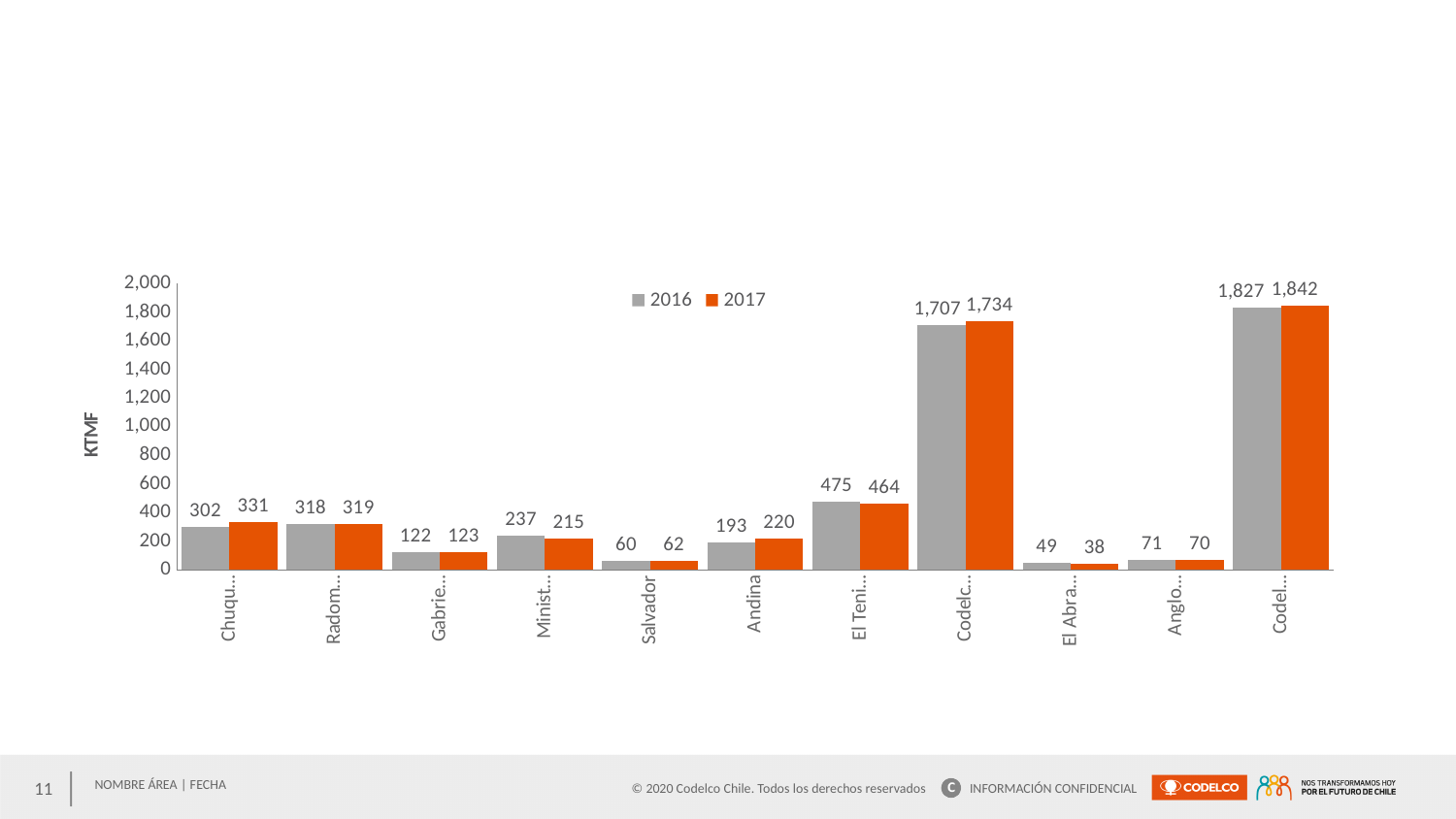
How many series does the legend list? 2 What is the lowest 2016 value shown in the chart? 49 What is the 2017 value for the category labelled "El Teni..."? 464 By how much did the value for Andina increase from 2016 to 2017? 27 What is the 2016 value for Salvador? 60 What is the highest 2017 value shown in the chart? 1,842 How many categories are shown on the x axis? 11 What is the difference between the 2016 and 2017 values for the category labelled "El Abra..."? 11 What is the label on the vertical axis? KTMF What kind of chart is shown on the slide? Bar chart What is the 2017 value for Andina? 220 For Salvador, which year has the larger value, 2016 or 2017? 2017